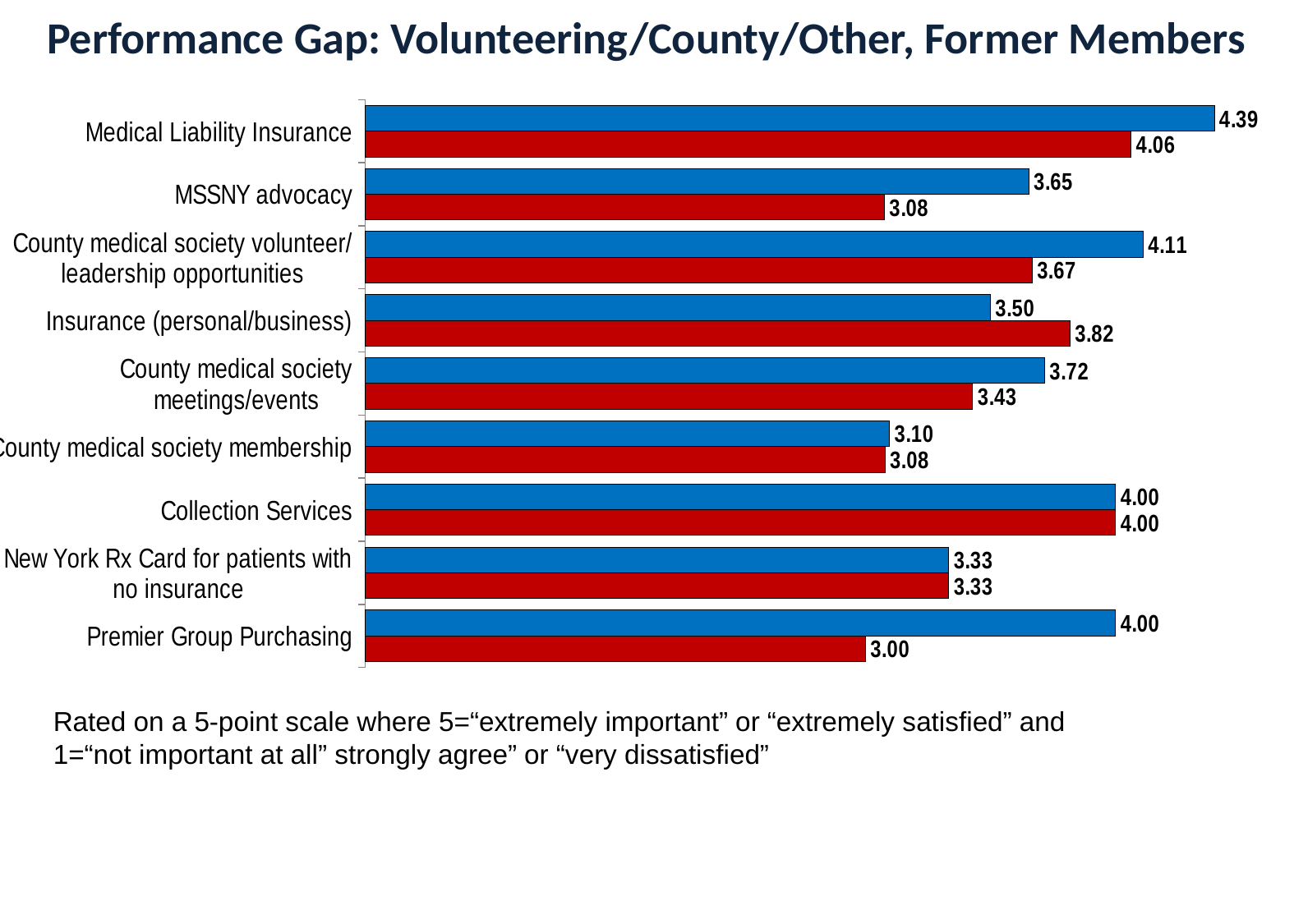
What is the difference between the blue and red bar values for Premier Group Purchasing? 1.00 Which category has the highest blue bar value? Medical Liability Insurance What is the value of the blue bar for Medical Liability Insurance? 4.39 Which category has the lowest blue bar value? County medical society membership How many categories are shown on the chart? 9 What type of chart is shown on the slide? Bar chart What is the value of the blue bar for Premier Group Purchasing? 4.00 What is the difference between the blue and red bar values for MSSNY advocacy? 0.57 Which category has the lowest red bar value? Premier Group Purchasing For Insurance (personal/business), which is larger, the blue bar or the red bar? The red bar What is the value of the red bar for Insurance (personal/business)? 3.82 What is the value of the red bar for MSSNY advocacy? 3.08